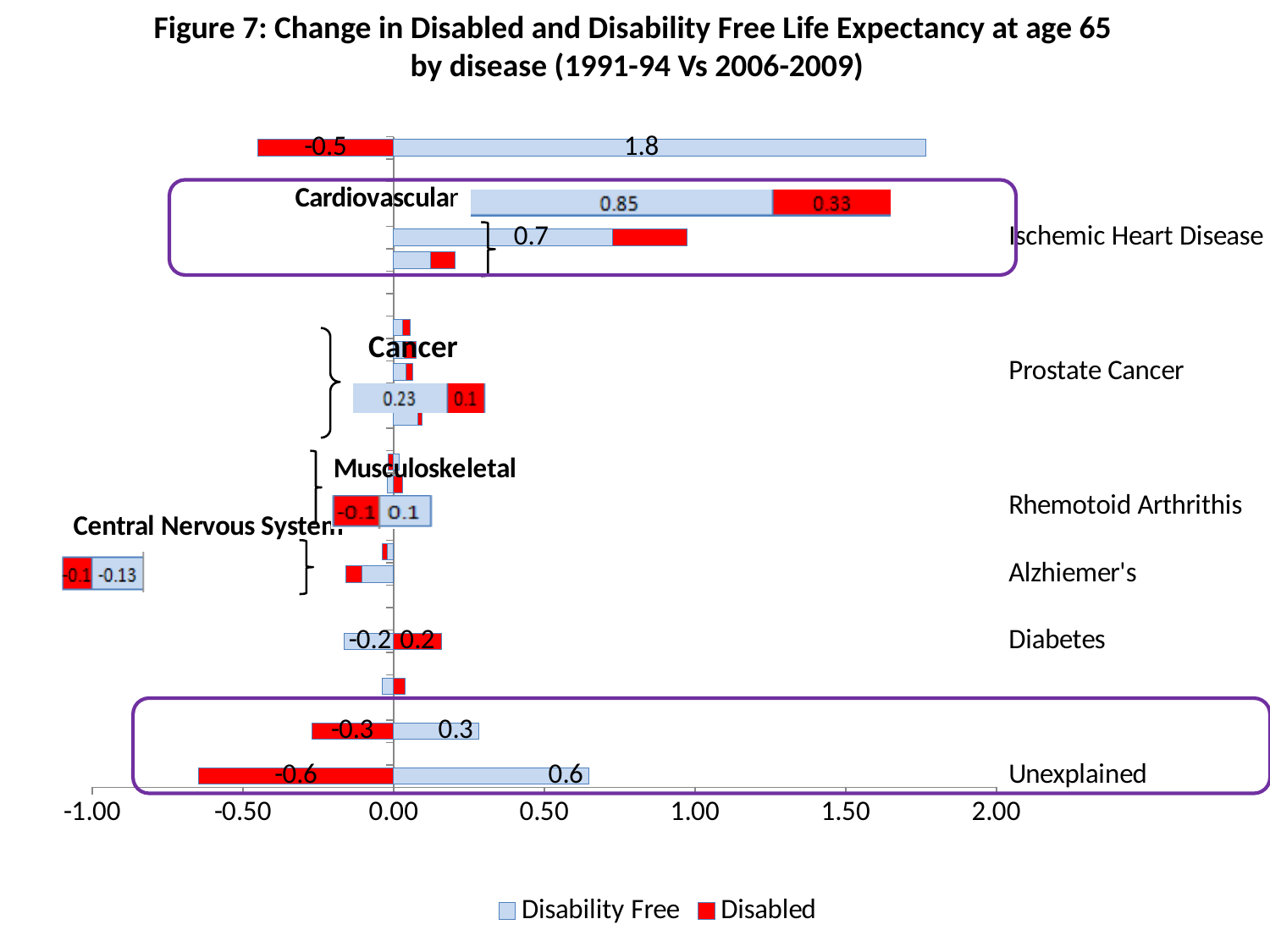
What is the Disability Free value for the Unexplained category? 0.6 What is the Disability Free value for Diabetes? -0.2 Is the Disability Free value of the topmost bar greater or less than 1.50? greater What is the difference between the Disability Free value of the topmost bar (1.8) and the Disability Free value for Unexplained (0.6)? 1.2 Which is larger: the Disability Free value for Unexplained (0.6) or the Disability Free value of the topmost bar (1.8)? 1.8 (topmost bar) What are the two series named in the legend? Disability Free and Disabled What is the Disabled value for the Unexplained category? -0.6 What kind of chart is shown on the slide? Bar chart How many series does the legend list? 2 What is the Disabled value on the topmost bar, which has a Disability Free value of 1.8? -0.5 What is the Disabled value for Diabetes? 0.2 What is the largest Disability Free value labelled on the chart? 1.8